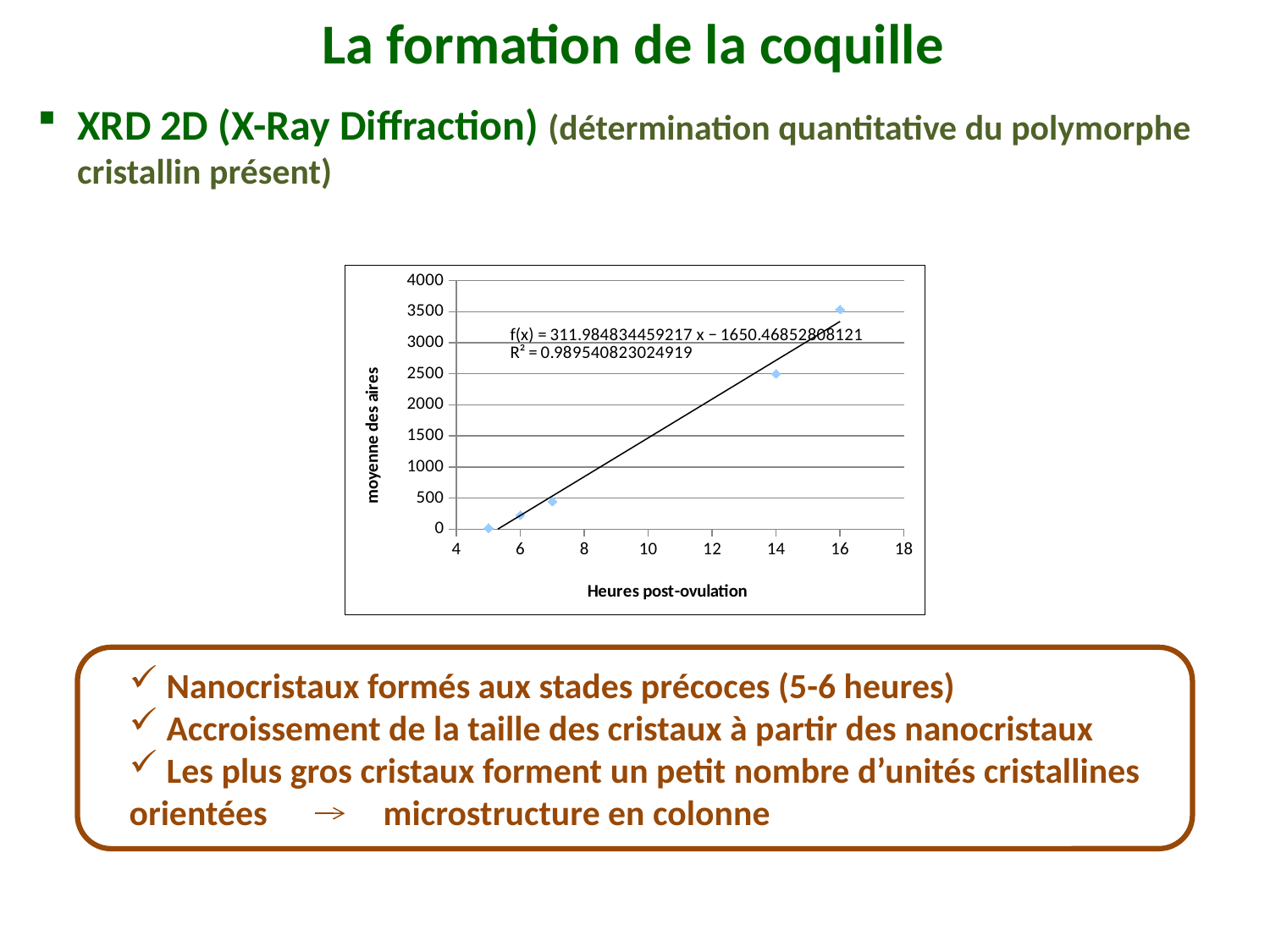
What R² value is printed on the chart for the trendline? 0.989540823024919 Do the values of 'moyenne des aires' rise or fall as 'Heures post-ovulation' increases? rise Is the value of 'moyenne des aires' at 5 hours post-ovulation greater or less than 500? less Is the value of 'moyenne des aires' at 14 hours post-ovulation greater or less than 2000? greater How many data points are plotted on the chart? 5 Is the value of 'moyenne des aires' at 7 hours post-ovulation greater or less than 1000? less What kind of chart is shown on the slide? scatter chart At which value of 'Heures post-ovulation' is 'moyenne des aires' highest? 16 Which has the larger 'moyenne des aires': 14 hours post-ovulation or 7 hours post-ovulation? 14 hours post-ovulation What is the title of the x axis of the chart? Heures post-ovulation At which value of 'Heures post-ovulation' is 'moyenne des aires' lowest? 5